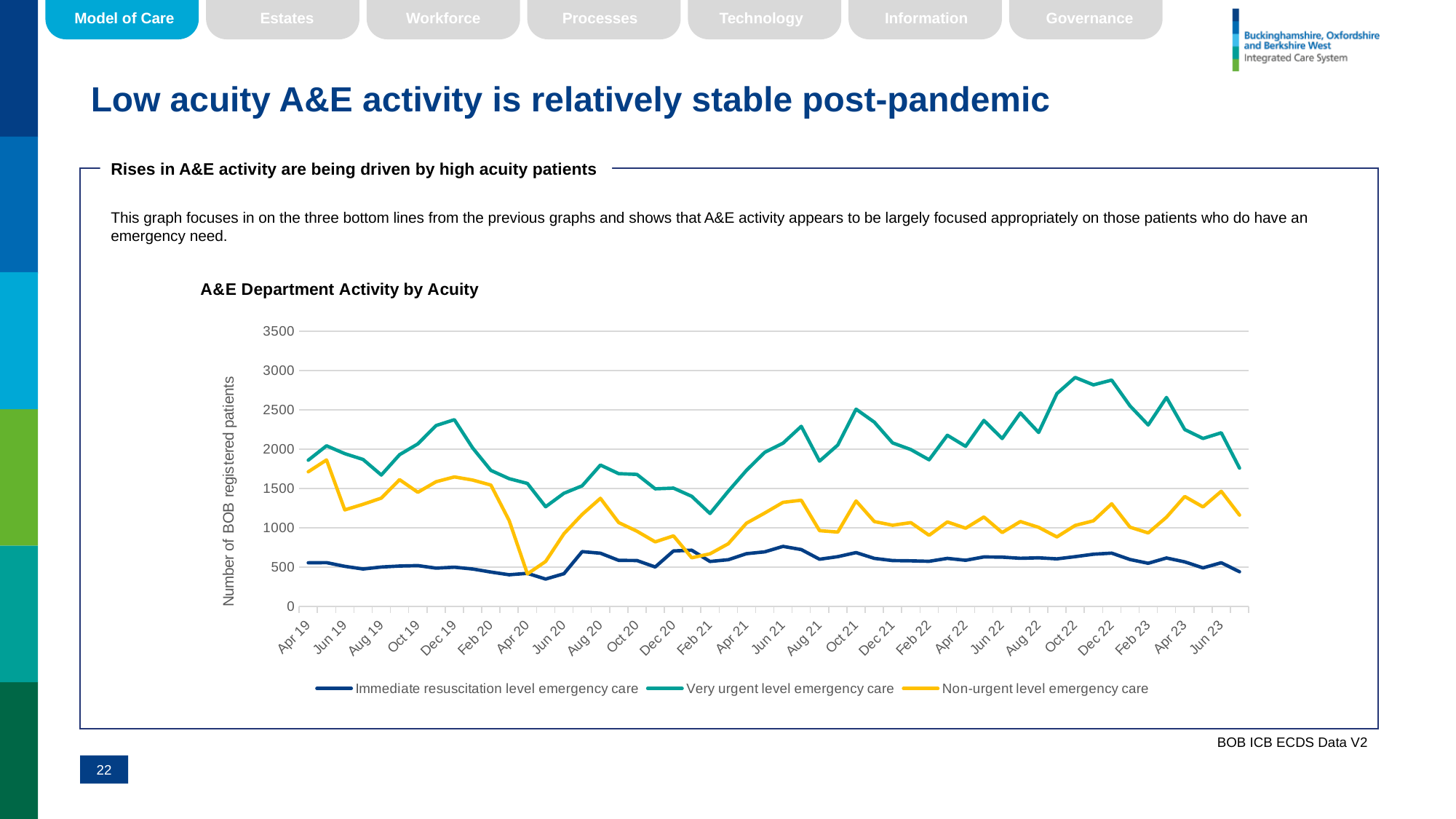
How many series does the legend of the A&E Department Activity by Acuity chart list? 3 Is the value for Immediate resuscitation level emergency care in Jun 21 greater or less than 1000? less Is the value for Very urgent level emergency care in Oct 22 greater or less than 2500? greater Is the value for Non-urgent level emergency care in Apr 20 greater or less than 1000? less What is the label on the vertical axis of the chart? Number of BOB registered patients What kind of chart is shown on the slide? line chart In Jun 23, which is larger: Very urgent level emergency care or Non-urgent level emergency care? Very urgent level emergency care Which series has the lowest values across the whole period shown? Immediate resuscitation level emergency care Which series has the highest value in Oct 22? Very urgent level emergency care What is the title of the chart on the slide? A&E Department Activity by Acuity Does the Non-urgent level emergency care line rise or fall between Dec 19 and Apr 20? fall